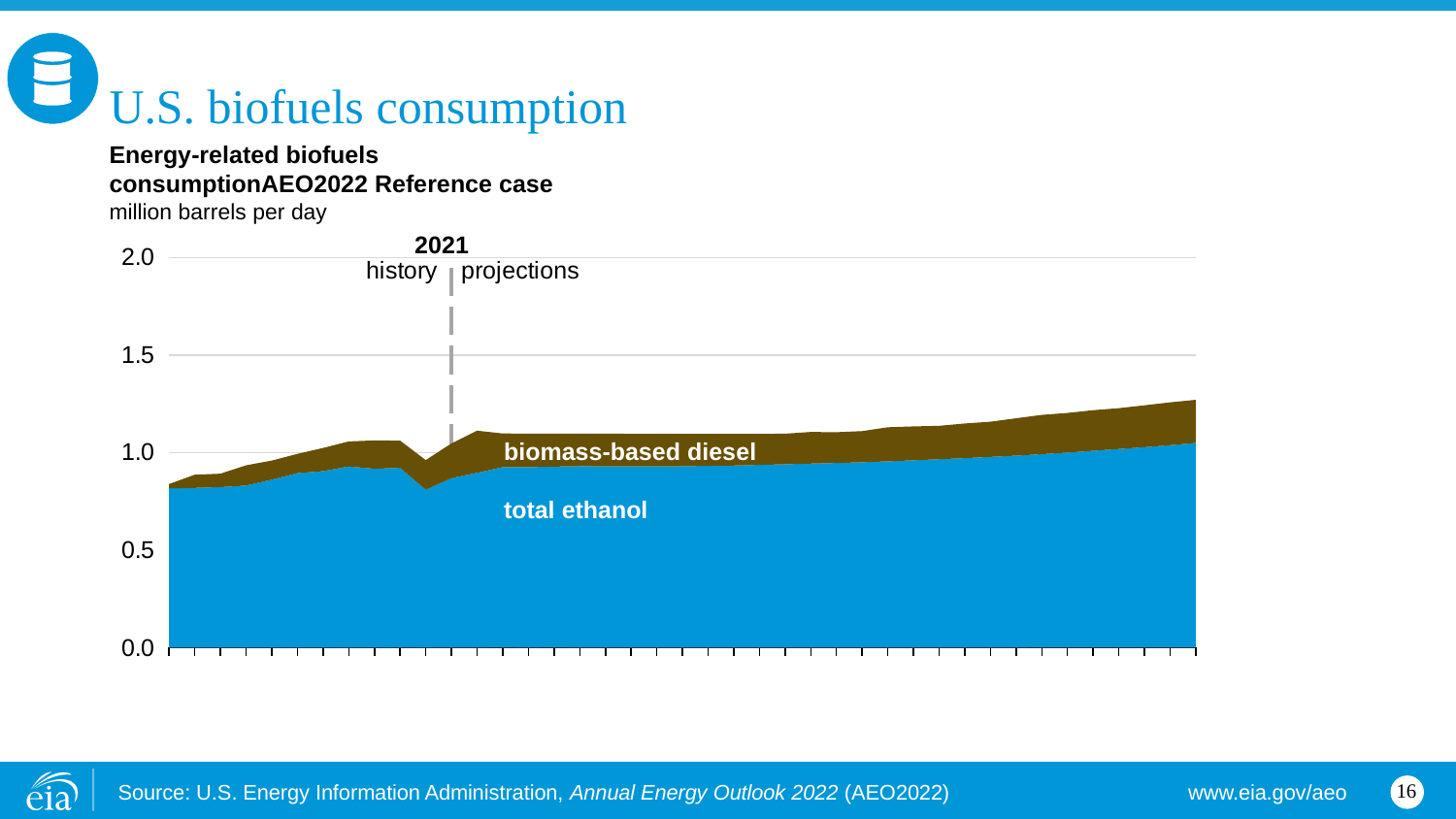
Is the total biofuels consumption at the left end of the chart greater or less than 1.0 million barrels per day? less Is the total biofuels consumption at the right end of the chart greater or less than 1.5 million barrels per day? less Which series is larger throughout the chart, total ethanol or biomass-based diesel? total ethanol What kind of chart is shown on the slide? stacked area chart What are the two series shown in the chart? total ethanol and biomass-based diesel How many series are plotted in the chart? 2 Is the total biofuels consumption at the right end of the chart greater or less than 1.0 million barrels per day? greater Which series is the smaller of the two in the chart? biomass-based diesel What is the highest value shown on the vertical axis? 2.0 What unit is the chart measured in? million barrels per day Does total biofuels consumption rise or fall over the projection period? rise